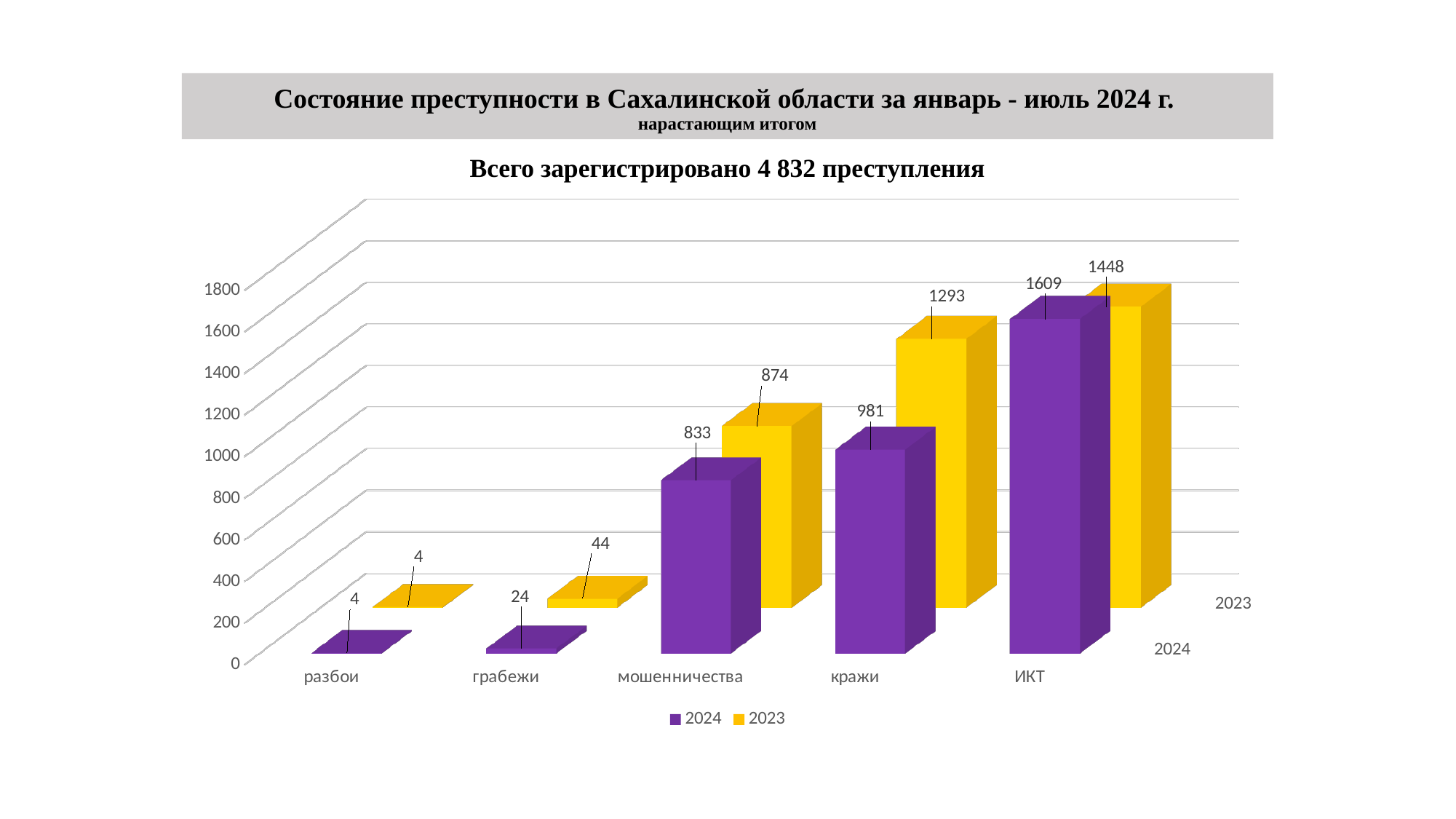
What is the difference between the 2024 and 2023 values for ИКТ? 161 Which is larger for ИКТ: the 2024 value or the 2023 value? 2024 What is the value for кражи in the 2023 series? 1293 How many categories are shown on the x axis? 5 What kind of chart is shown on the slide? Bar chart How many series does the legend list? 2 Which category has the lowest value in the 2023 series? разбои What is the value for мошенничества in the 2024 series? 833 What is the difference between the 2023 and 2024 values for кражи? 312 Which colour represents the 2023 series in the legend? Yellow Which category has the highest value in the 2024 series? ИКТ What is the value for грабежи in the 2023 series? 44